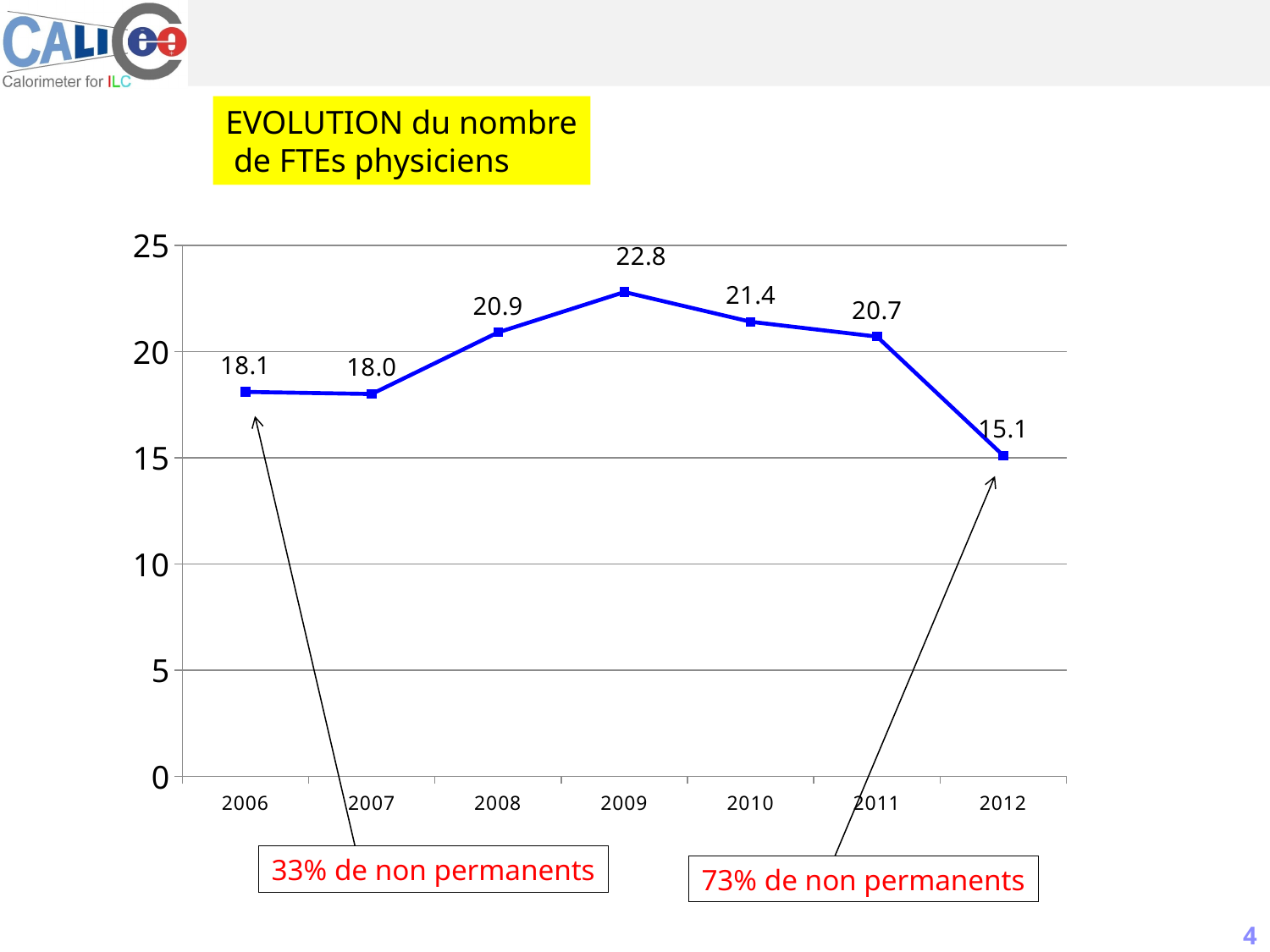
How many years are plotted on the chart? 7 What is the difference between the 2009 value and the 2012 value? 7.7 What is the difference between the 2008 value and the 2007 value? 2.9 Is the value for 2011 greater or less than 20? greater Which year has the highest number of FTEs? 2009 What kind of chart is shown on the slide? line chart What is the number of physicist FTEs in 2009? 22.8 What is the value plotted for 2012? 15.1 What is the value plotted for 2006? 18.1 Do the values rise or fall from 2009 to 2012? fall Which year has a larger value, 2010 or 2011? 2010 Which year has the lowest number of FTEs? 2012